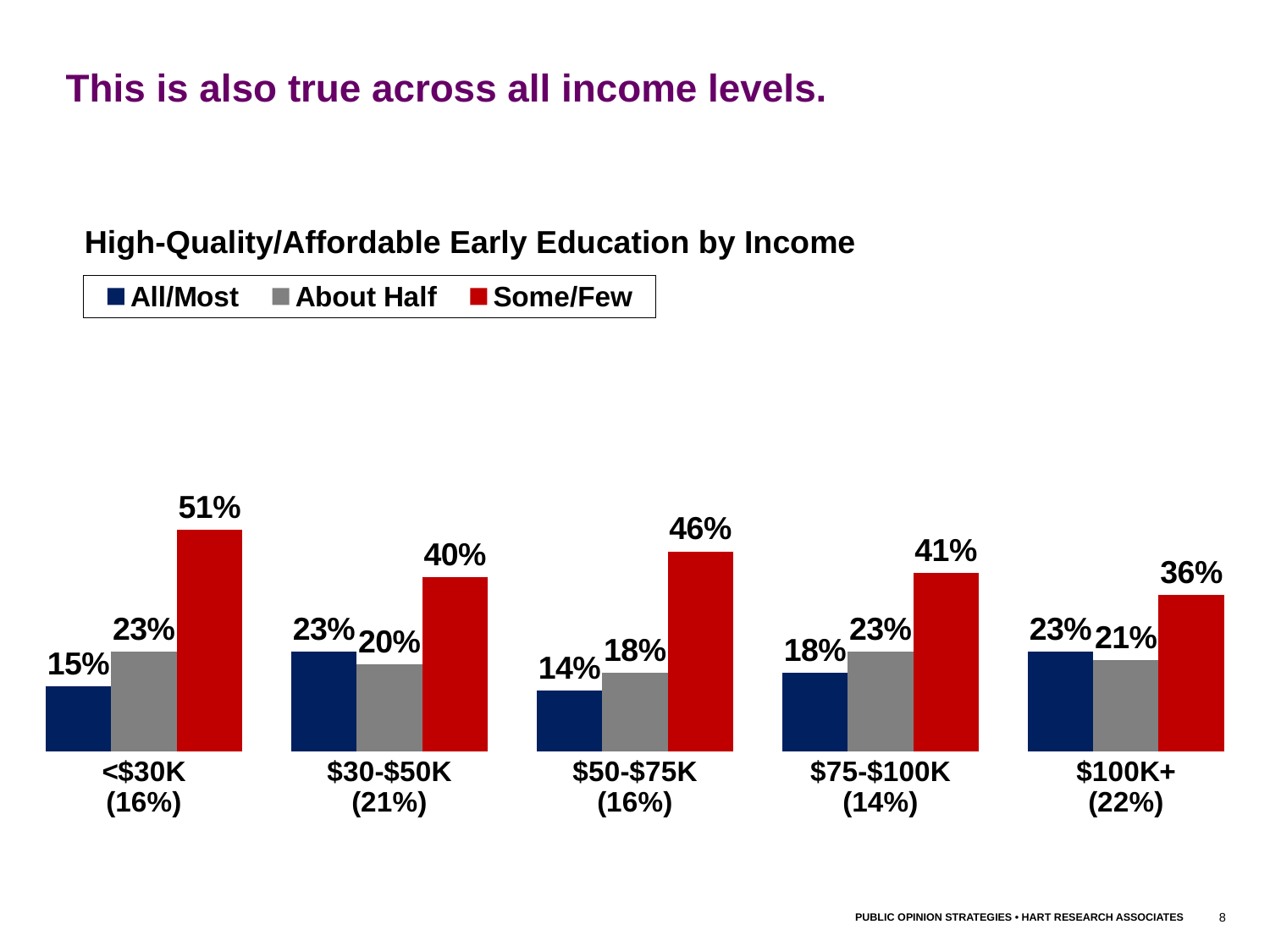
Which income group has the highest Some/Few value? <$30K What is the difference between the Some/Few values for <$30K and $100K+? 15% What kind of chart is shown on the slide? Bar chart How many income groups are shown on the x axis? 5 What is the title of the chart? High-Quality/Affordable Early Education by Income What is the All/Most value for the $50-$75K income group? 14% Which is larger for the $30-$50K group: All/Most or About Half? All/Most Which income group has the lowest All/Most value? $50-$75K How many series does the legend list? 3 What is the About Half value for the $100K+ income group? 21% What is the Some/Few value for the <$30K income group? 51%